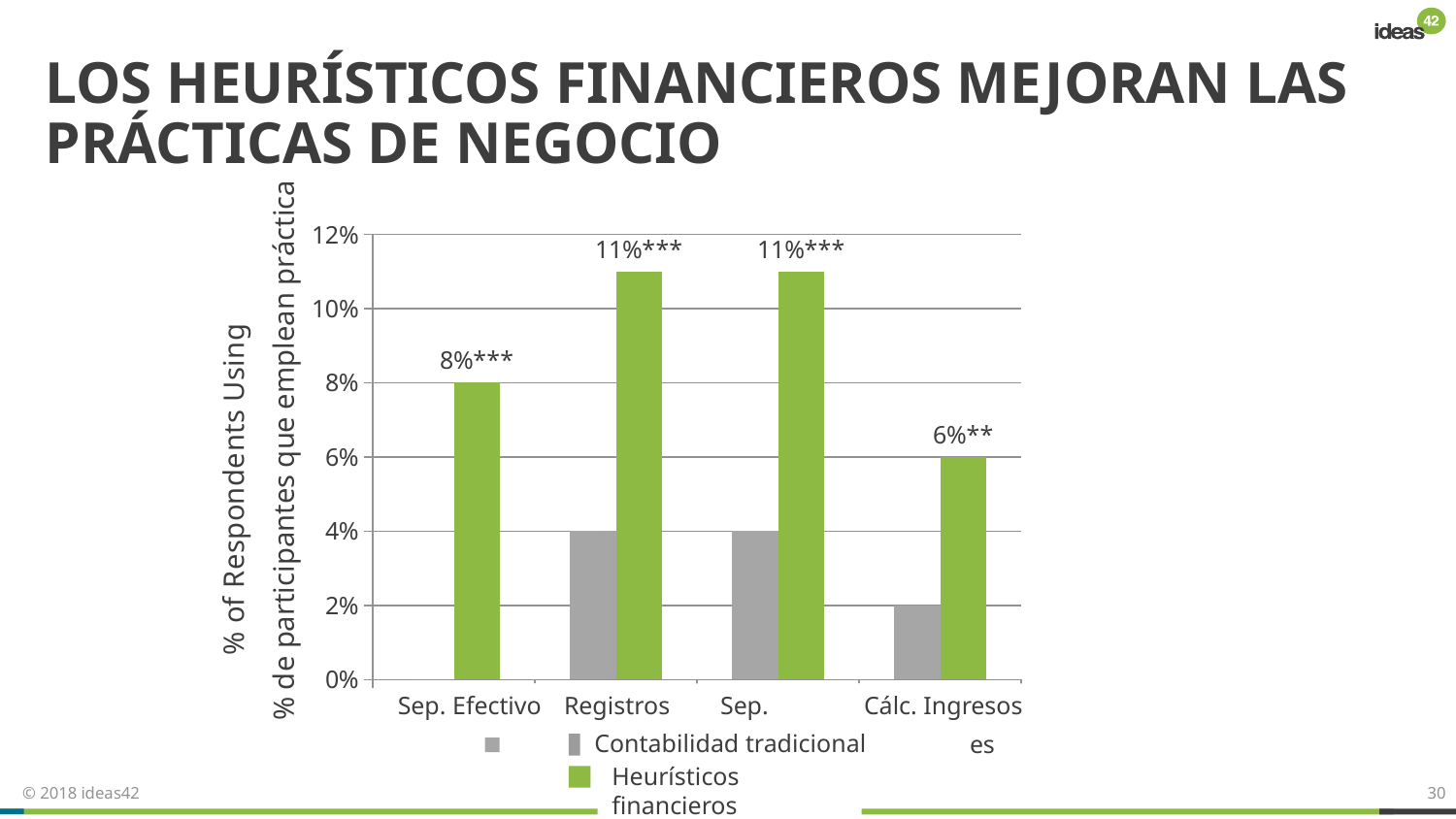
Is the Contabilidad tradicional value for Cálc. Ingresos greater or less than 4%? less What kind of chart is shown on the slide? bar chart What is the difference between the Heurísticos financieros values for Registros and Cálc. Ingresos? 5% What colour are the Heurísticos financieros bars? green How many categories are shown on the x axis? 4 How many data series does the legend list? 2 Which is larger for Sep. Efectivo: the Heurísticos financieros bar or the Contabilidad tradicional bar? Heurísticos financieros Is the Contabilidad tradicional value for Registros greater or less than 6%? less What is the value of the Heurísticos financieros bar for Registros? 11%*** Which category has the lowest Heurísticos financieros value? Cálc. Ingresos What is the value of the Heurísticos financieros bar for Sep. Efectivo? 8%*** What is the value of the Heurísticos financieros bar for Cálc. Ingresos? 6%**